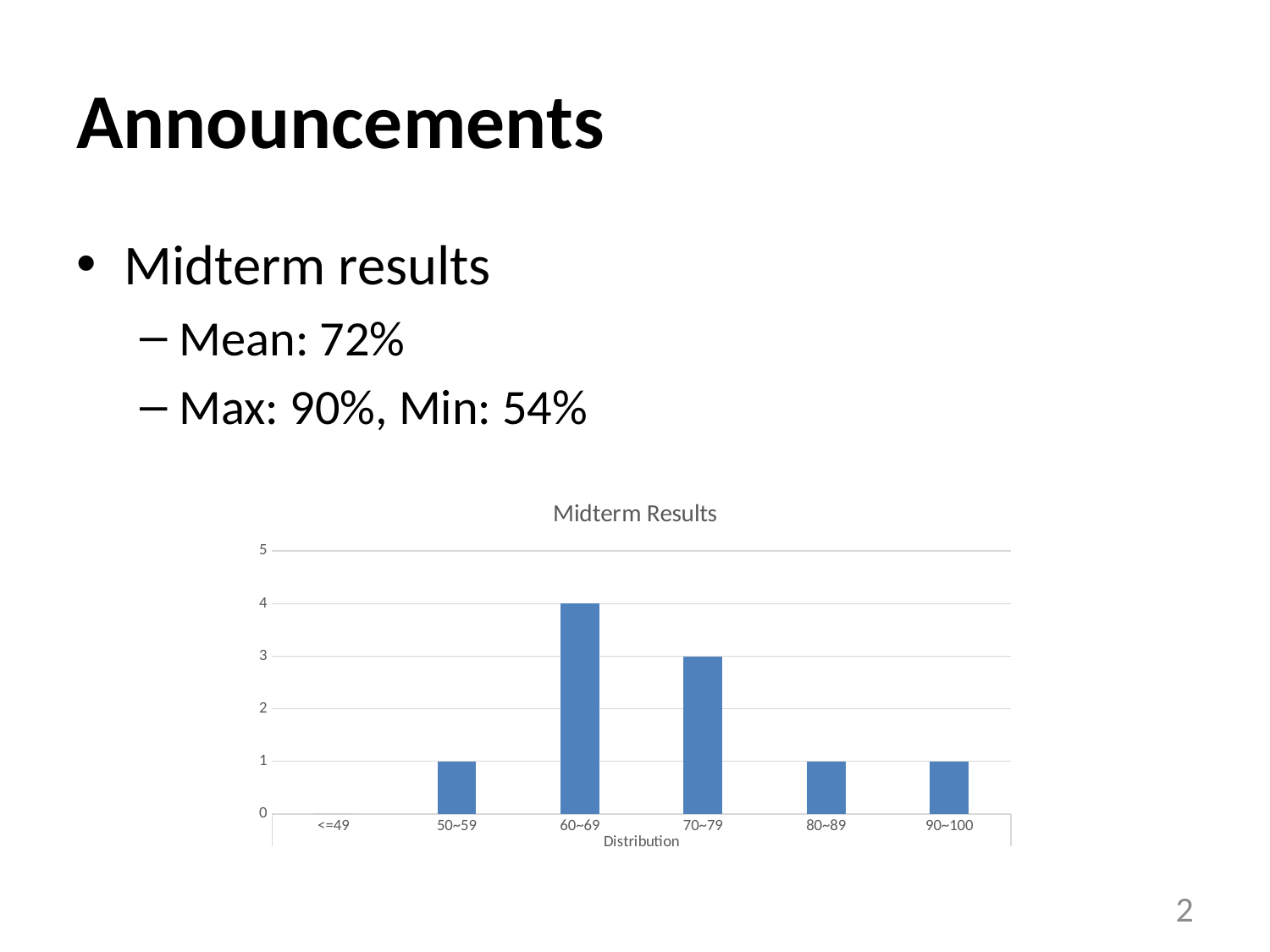
What is the title of the chart? Midterm Results What is the difference between the values for 60~69 and 70~79? 1 What is the label of the x axis? Distribution Which is larger, the value for 70~79 or the value for 80~89? 70~79 How many score categories are shown on the x axis of the chart? 6 Which category has the highest value? 60~69 What is the value for the 70~79 category? 3 What is the value for the <=49 category? 0 Which category has the lowest value? <=49 What type of chart is shown on the slide? bar chart What is the value for the 60~69 category? 4 What is the value for the 50~59 category? 1